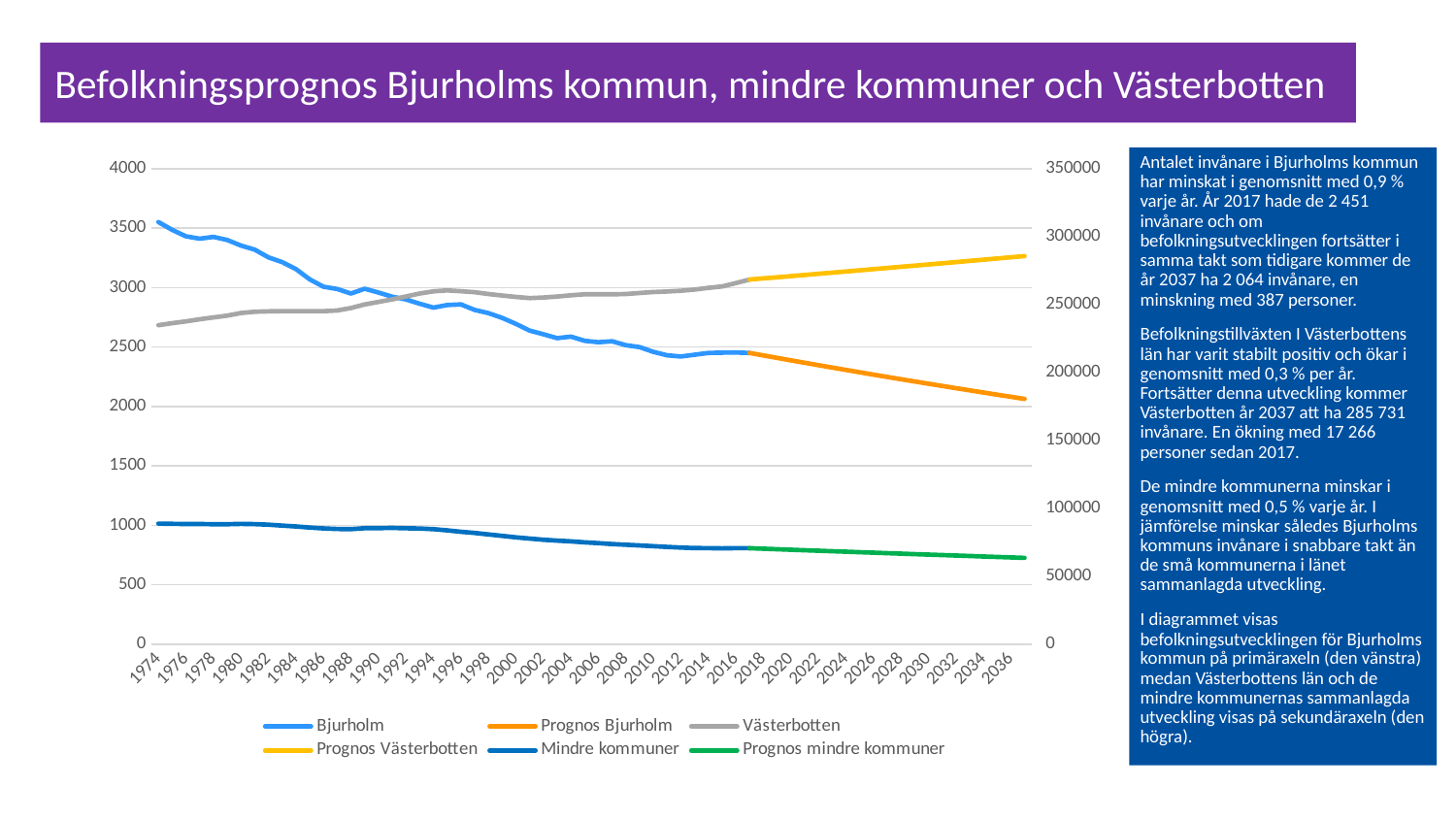
Is the value for Prognos Bjurholm in 2036 greater or less than 2000? greater Does the Västerbotten series rise or fall overall from 1974 to 2016? rise What is the title of the slide's chart? Befolkningsprognos Bjurholms kommun, mindre kommuner och Västerbotten Is the value for Bjurholm in 1974 greater or less than 3000? greater Does the Bjurholm series rise or fall from 1974 to 2016? fall Which colour is used for the Prognos Bjurholm series? orange Is the value for Prognos Västerbotten in 2036 greater or less than 250000 on the secondary axis? greater Which is larger for Bjurholm: the value in 1974 or the value in 2016? 1974 How many series does the legend list? 6 Does the Mindre kommuner series rise or fall from 1974 to 2016? fall What kind of chart is shown on the slide? line chart